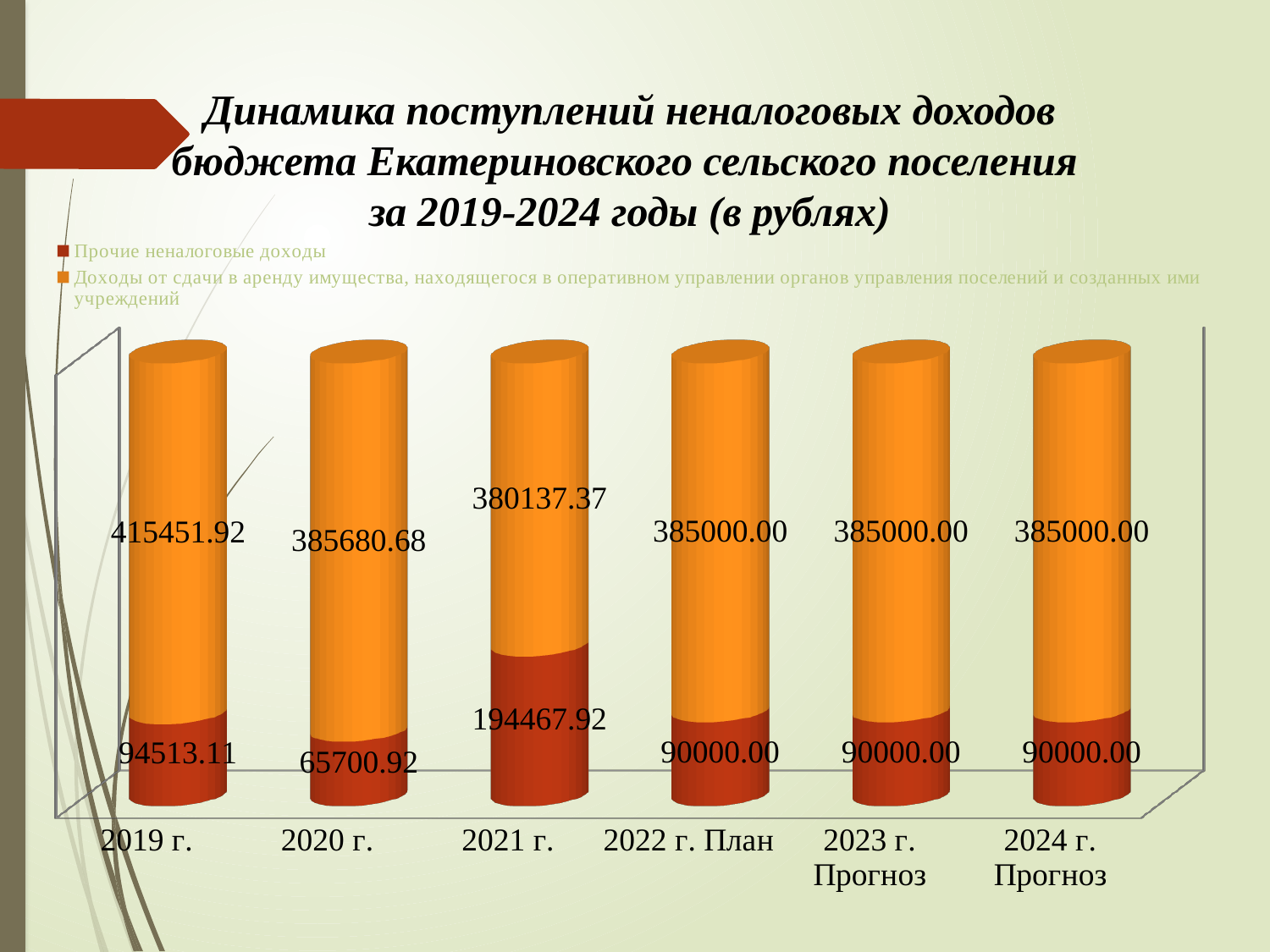
Which year has the lowest value for Прочие неналоговые доходы? 2020 г. What is the value of Прочие неналоговые доходы for 2019 г.? 94513.11 How many categories (years) are shown on the x axis? 6 Which is larger: Прочие неналоговые доходы in 2021 г. or in 2019 г.? 2021 г. What is the difference between the Доходы от сдачи в аренду имущества values for 2019 г. and 2020 г.? 29771.24 What is the total of the stacked bar for 2022 г. План? 475000.00 What is the value of Доходы от сдачи в аренду имущества for 2021 г.? 380137.37 What is the value of Прочие неналоговые доходы for 2022 г. План? 90000.00 How many series does the legend list? 2 What kind of chart is shown on the slide? Stacked bar chart Which year has the highest value for Прочие неналоговые доходы? 2021 г. Which year has the highest value for Доходы от сдачи в аренду имущества? 2019 г.